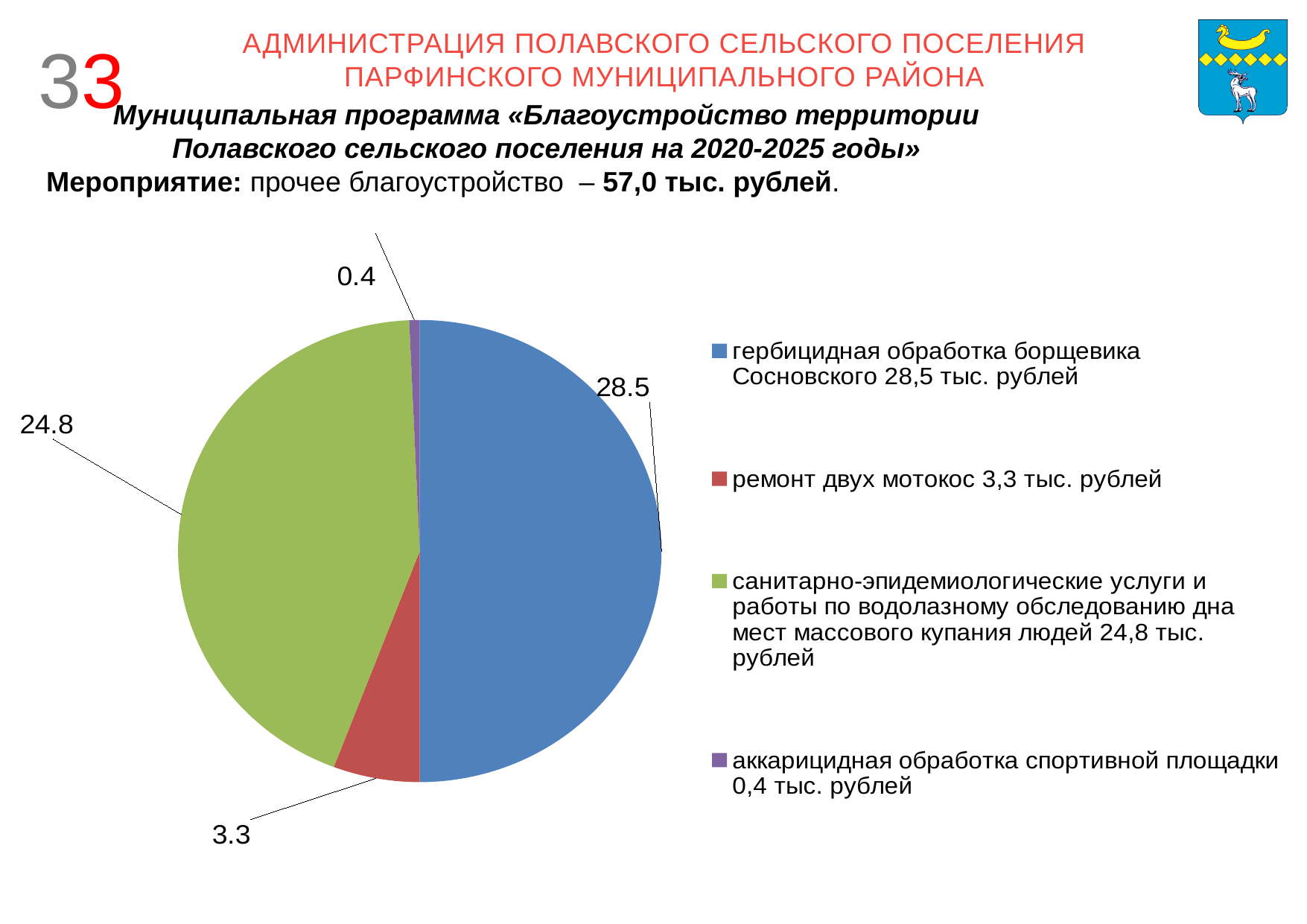
What is the value shown for гербицидная обработка борщевика Сосновского? 28.5 What colour is the slice for санитарно-эпидемиологические услуги in the pie chart? green Which category has the smallest slice of the pie chart? аккарицидная обработка спортивной площадки What is the value shown for ремонт двух мотокос? 3.3 What is the difference between the values for гербицидная обработка борщевика Сосновского and санитарно-эпидемиологические услуги? 3.7 Which is larger: the value for ремонт двух мотокос or the value for санитарно-эпидемиологические услуги? санитарно-эпидемиологические услуги How many slices does the pie chart have? 4 What is the value shown for аккарицидная обработка спортивной площадки? 0.4 How many entries does the legend of the pie chart list? 4 What share of the total 57,0 тыс. рублей does гербицидная обработка борщевика Сосновского (28.5) represent? 50% Which category has the largest slice of the pie chart? гербицидная обработка борщевика Сосновского What type of chart is shown on the slide? pie chart